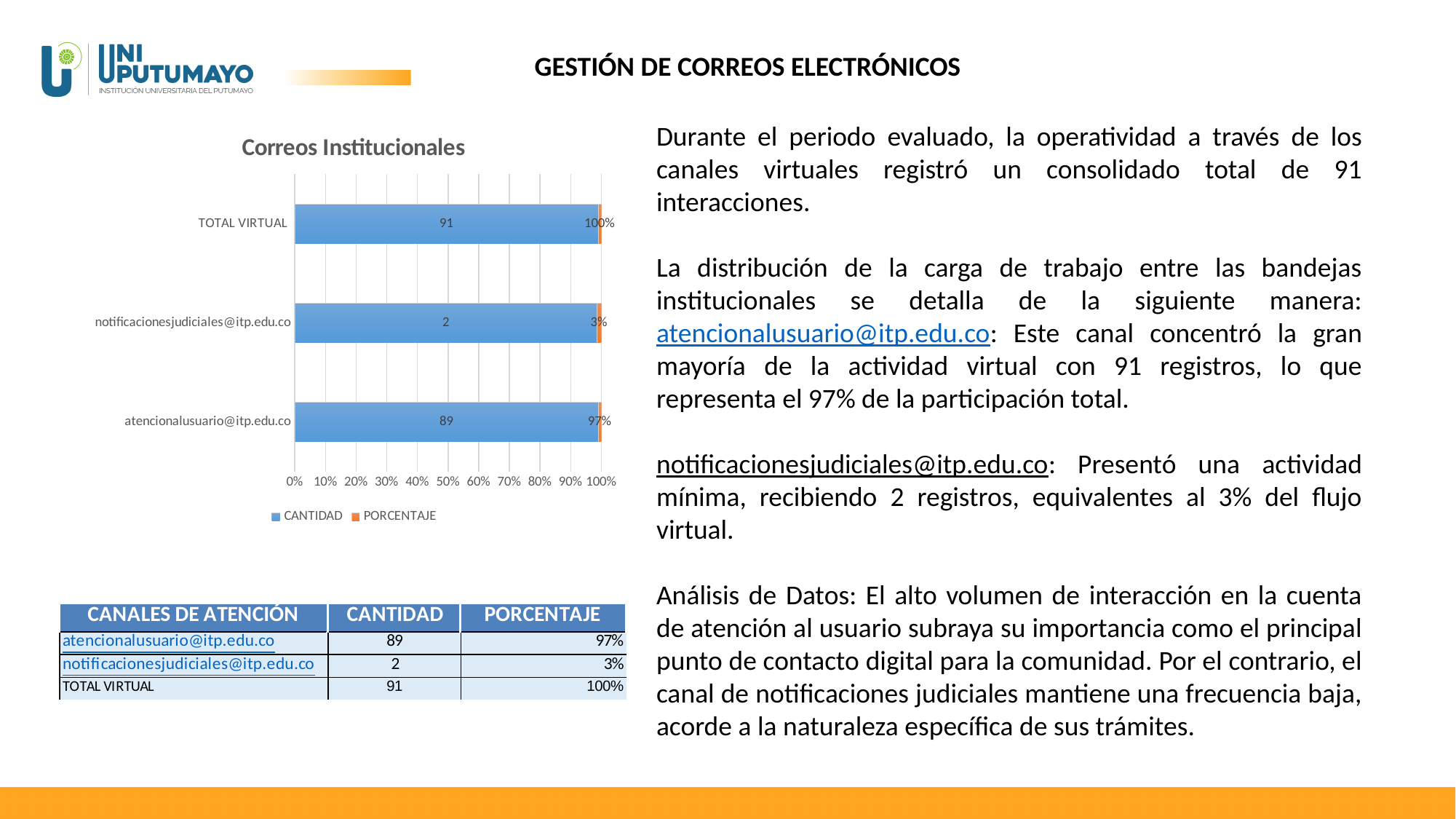
What is the CANTIDAD value for TOTAL VIRTUAL in the "Correos Institucionales" chart? 91 What is the PORCENTAJE value for notificacionesjudiciales@itp.edu.co in the "Correos Institucionales" chart? 3% What is the CANTIDAD value for atencionalusuario@itp.edu.co in the "Correos Institucionales" chart? 89 Which category has the lowest CANTIDAD value in the "Correos Institucionales" chart? notificacionesjudiciales@itp.edu.co How many series does the legend of the "Correos Institucionales" chart list? 2 What is the difference between the CANTIDAD values for atencionalusuario@itp.edu.co and notificacionesjudiciales@itp.edu.co in the "Correos Institucionales" chart? 87 How many categories are shown in the "Correos Institucionales" chart? 3 Which has a larger CANTIDAD value in the "Correos Institucionales" chart: atencionalusuario@itp.edu.co or notificacionesjudiciales@itp.edu.co? atencionalusuario@itp.edu.co Which category has the highest CANTIDAD value in the "Correos Institucionales" chart? TOTAL VIRTUAL What are the two series named in the legend of the "Correos Institucionales" chart? CANTIDAD and PORCENTAJE What type of chart is shown under the title "Correos Institucionales"? Bar chart What is the PORCENTAJE value for atencionalusuario@itp.edu.co in the "Correos Institucionales" chart? 97%